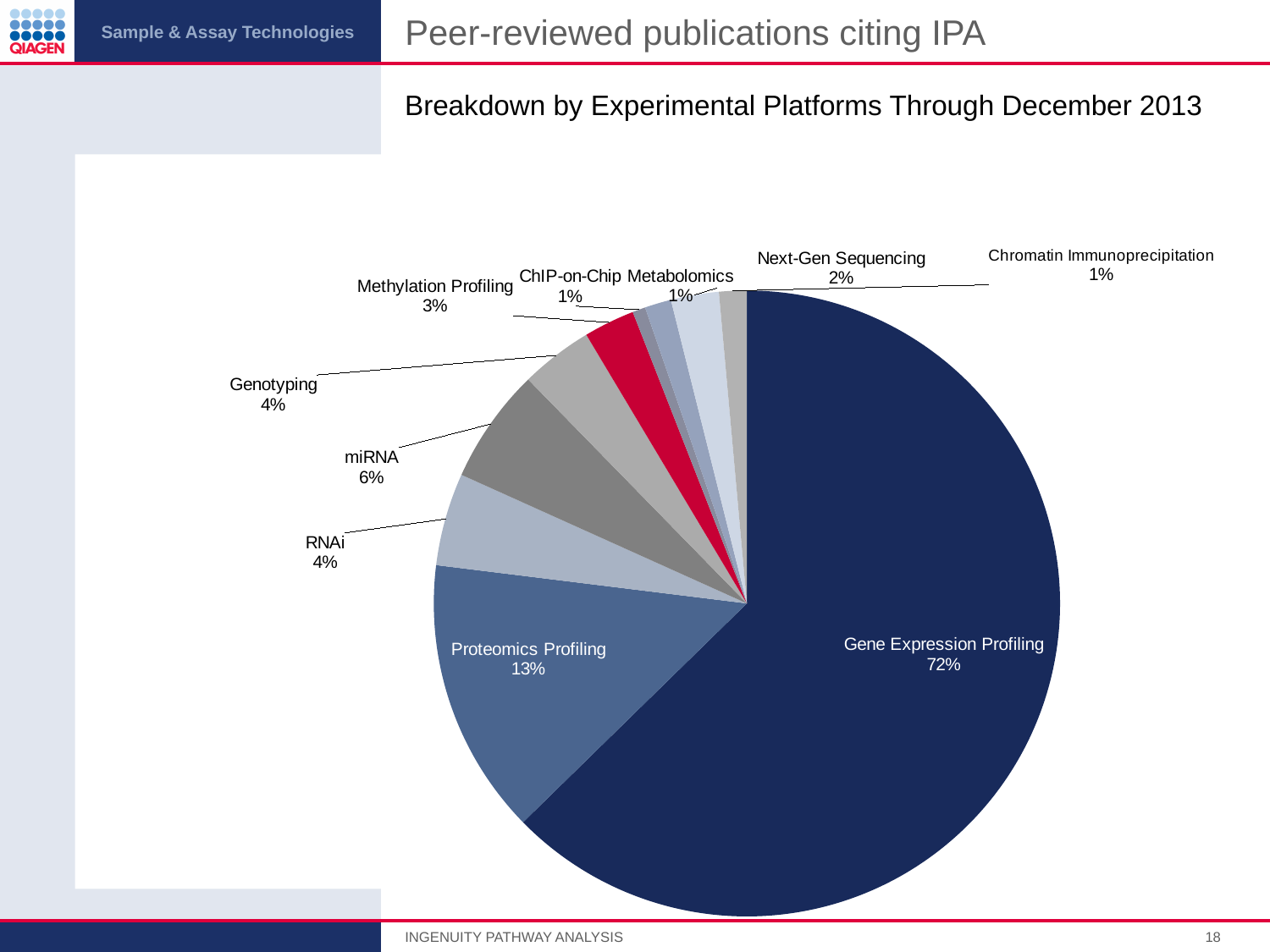
Which is larger, the share for miRNA or the share for Genotyping? miRNA How many experimental platform categories are shown in the pie chart? 10 What share of publications is attributed to Gene Expression Profiling? 72% What is the subtitle describing the breakdown shown in the chart? Breakdown by Experimental Platforms Through December 2013 What percentage is shown for Proteomics Profiling? 13% Which experimental platform has the largest share of the pie? Gene Expression Profiling What percentage is shown for Next-Gen Sequencing? 2% What percentage is shown for miRNA? 6% What type of chart is shown on the slide? Pie chart What is the difference in percentage points between Gene Expression Profiling and Proteomics Profiling? 59 What percentage is shown for RNAi? 4% What percentage is shown for Methylation Profiling? 3%